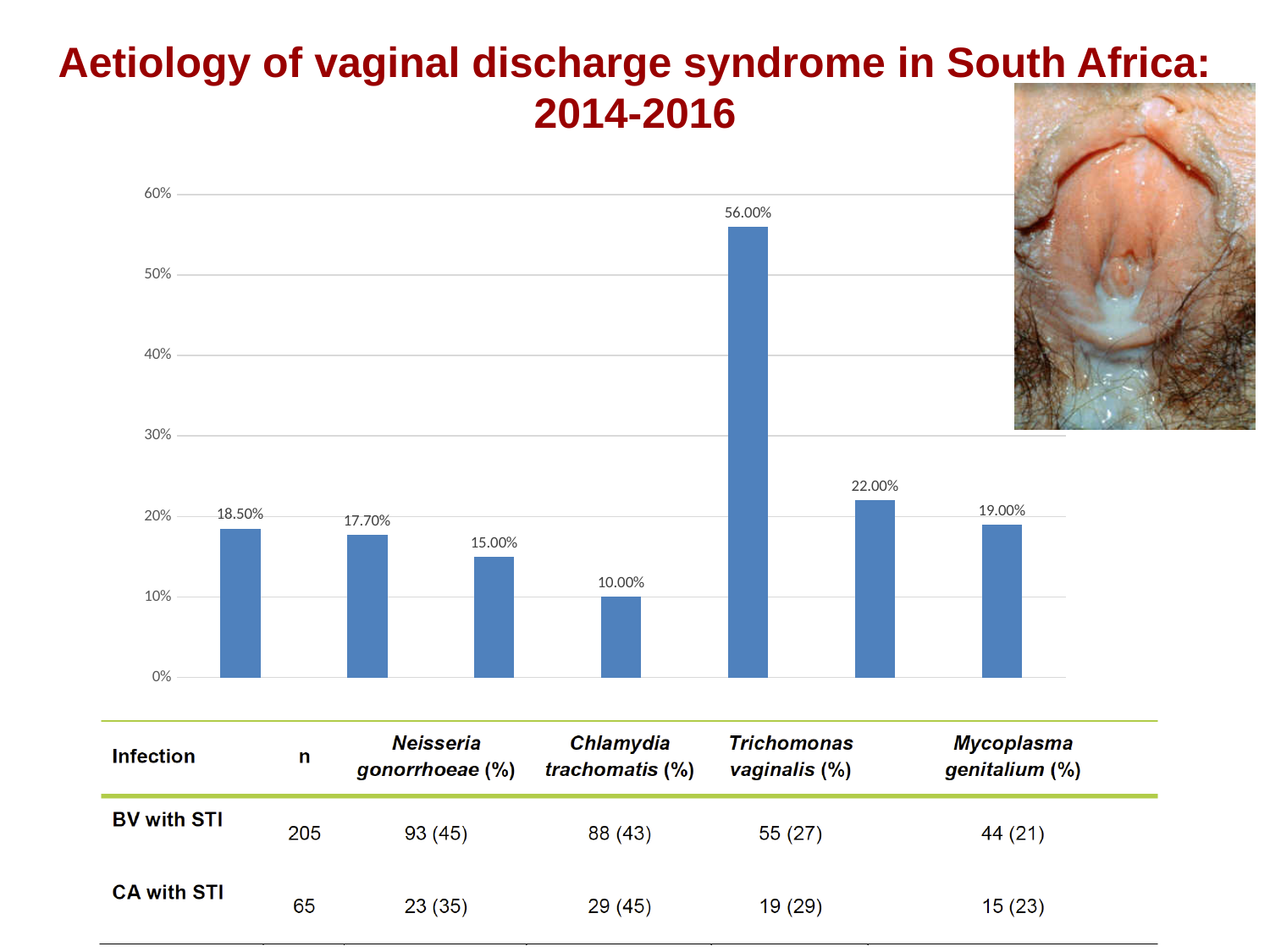
What is the data label on the sixth bar from the left? 22.00% How many bars are plotted in the chart? 7 What is the data label on the first bar from the left? 18.50% What is the difference between the tallest bar (56.00%) and the shortest bar (10.00%)? 46.00% What is the data label on the second bar from the left? 17.70% What is the data label on the last bar on the right? 19.00% What is the highest value shown on the vertical axis of the chart? 60% Is the value of the fifth bar from the left greater or less than 50%? greater What is the value shown on the tallest bar in the chart? 56.00% What is the value shown on the shortest bar in the chart? 10.00% Which is larger, the first bar from the left (18.50%) or the third bar from the left (15.00%)? the first bar (18.50%) What kind of chart is shown on the slide? bar chart